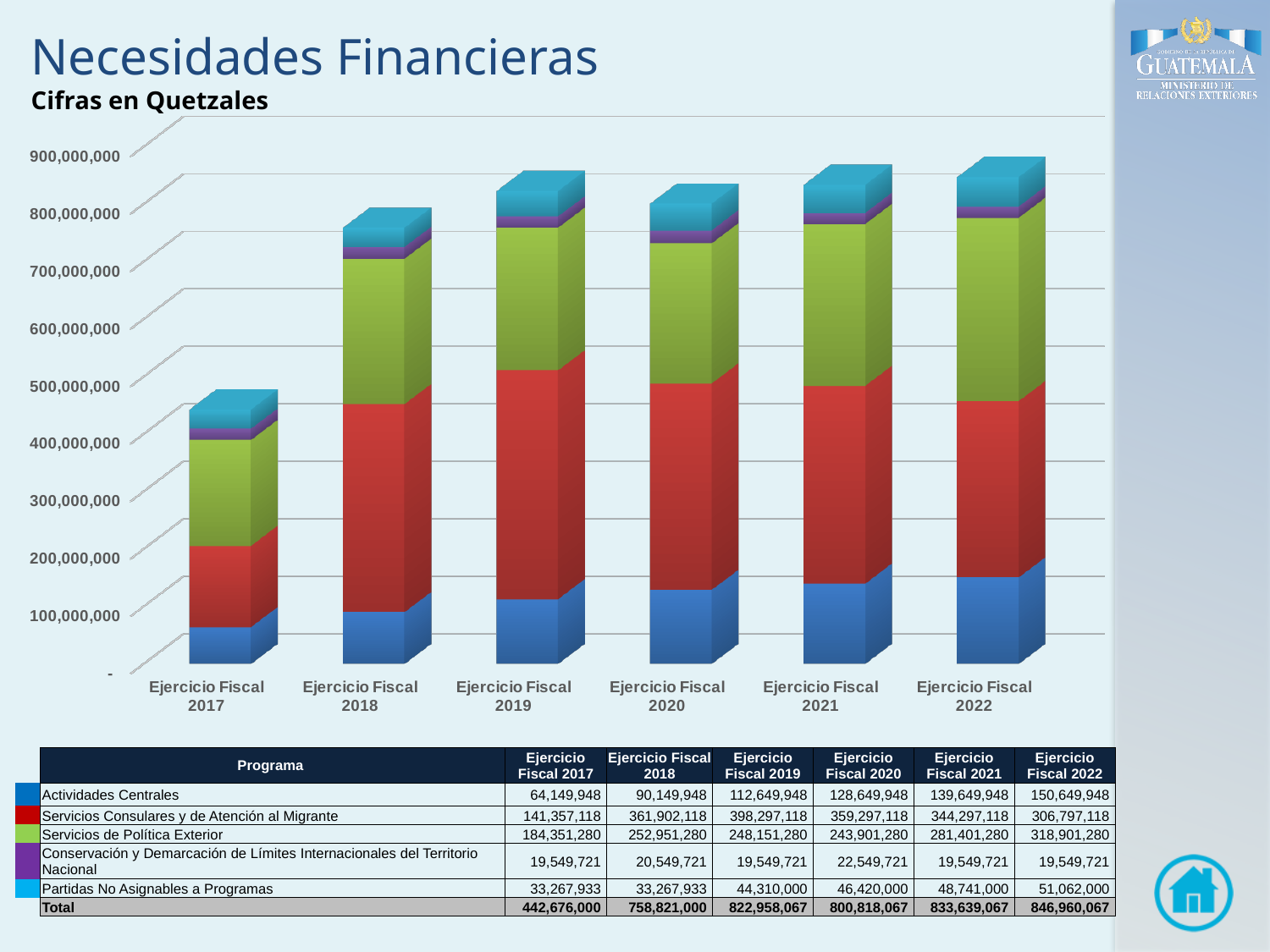
By how much did Actividades Centrales increase from Ejercicio Fiscal 2017 to Ejercicio Fiscal 2022? 86,500,000 In Ejercicio Fiscal 2018, which is larger: Servicios Consulares y de Atención al Migrante or Servicios de Política Exterior? Servicios Consulares y de Atención al Migrante What is the value of Servicios de Política Exterior for Ejercicio Fiscal 2022? 318,901,280 What is the value of Actividades Centrales for Ejercicio Fiscal 2020? 128,649,948 How many programs (series) are stacked in each bar of the chart? 5 Which fiscal year has the lowest total? Ejercicio Fiscal 2017 Does the value of Actividades Centrales rise or fall from Ejercicio Fiscal 2017 to Ejercicio Fiscal 2022? rise What kind of chart is shown on the slide? Stacked bar chart Is the total bar for Ejercicio Fiscal 2017 greater or less than 500,000,000? less How many fiscal years (categories) are shown on the x axis of the chart? 6 Which fiscal year has the highest total? Ejercicio Fiscal 2022 What is the total for Ejercicio Fiscal 2019? 822,958,067